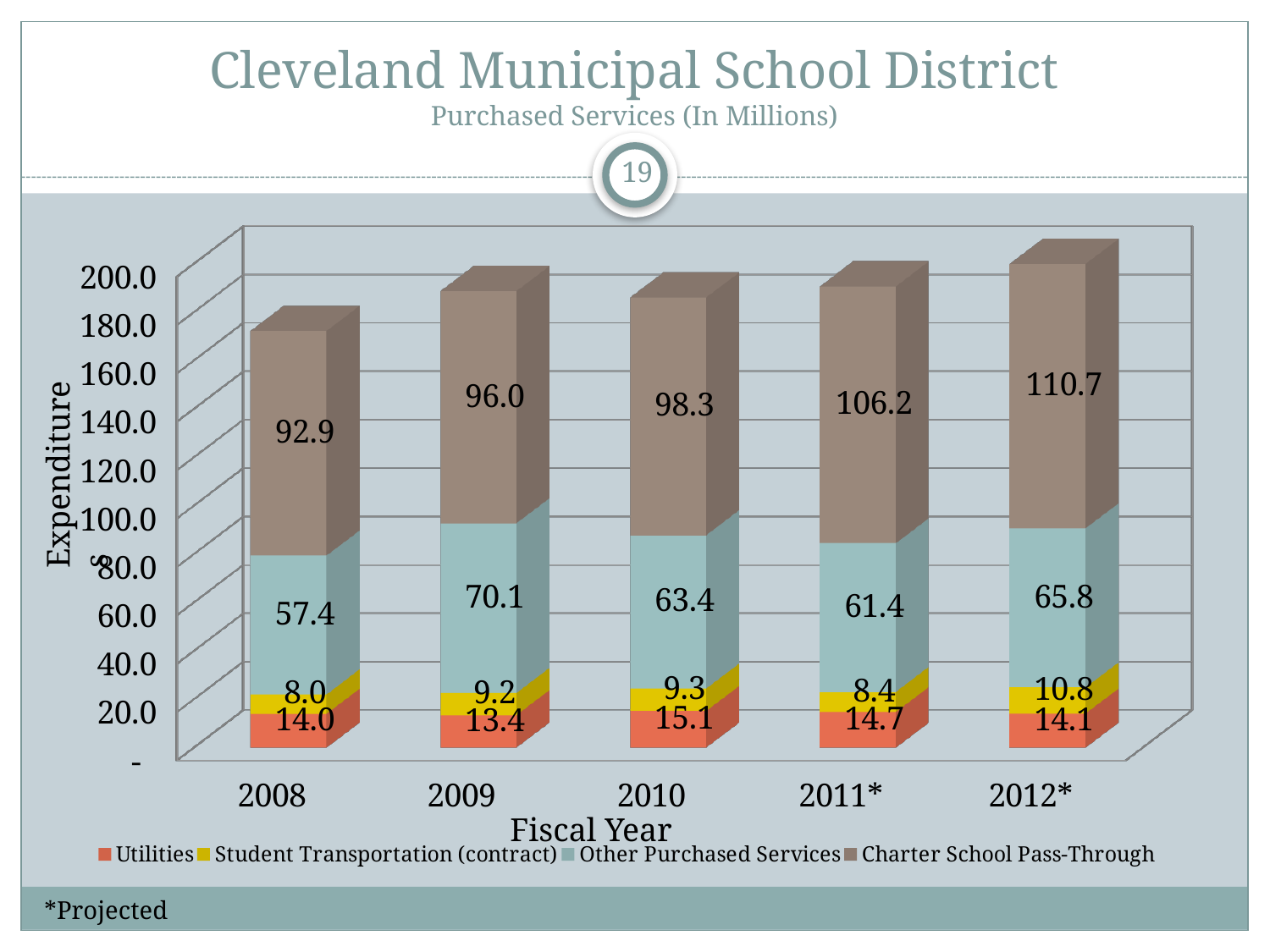
What is the total of the stacked bar for fiscal year 2008? 172.3 How many series does the legend list? 4 What is the Utilities value for fiscal year 2009? 13.4 What is the difference between the Charter School Pass-Through values for 2012* and 2008? 17.8 What kind of chart is shown on the slide? Stacked bar chart Which is larger, the Other Purchased Services value for 2009 or for 2011*? 2009 In which fiscal year is the Charter School Pass-Through value highest? 2012* In which fiscal year is the Student Transportation (contract) value lowest? 2008 Does the Charter School Pass-Through value rise or fall from 2008 to 2012*? Rise How many fiscal years are shown on the x axis? 5 What is the Charter School Pass-Through value for fiscal year 2010? 98.3 What is the Other Purchased Services value for fiscal year 2012*? 65.8